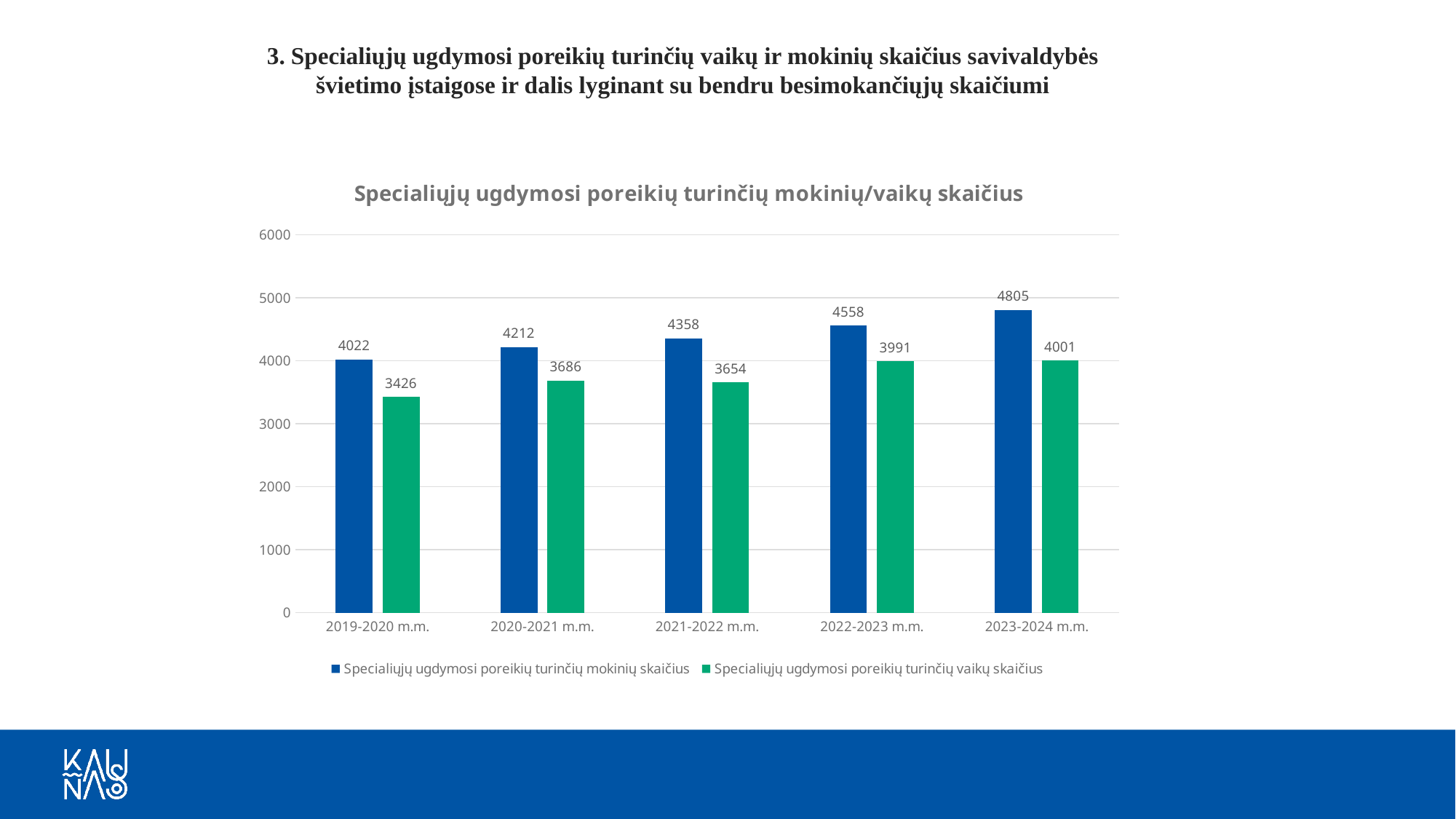
What is the value for 'Specialiųjų ugdymosi poreikių turinčių vaikų skaičius' in 2021-2022 m.m.? 3654 What is the value for 'Specialiųjų ugdymosi poreikių turinčių mokinių skaičius' in 2019-2020 m.m.? 4022 Does 'Specialiųjų ugdymosi poreikių turinčių mokinių skaičius' rise or fall across the school years from 2019-2020 to 2023-2024? Rises How many school years are shown on the x axis? 5 What is the value for 'Specialiųjų ugdymosi poreikių turinčių mokinių skaičius' in 2023-2024 m.m.? 4805 By how much did 'Specialiųjų ugdymosi poreikių turinčių mokinių skaičius' increase from 2019-2020 m.m. to 2023-2024 m.m.? 783 In which school year is 'Specialiųjų ugdymosi poreikių turinčių vaikų skaičius' the lowest? 2019-2020 m.m. Which is larger in 2020-2021 m.m.: the mokinių skaičius or the vaikų skaičius? Specialiųjų ugdymosi poreikių turinčių mokinių skaičius What kind of chart is shown on the slide? Bar chart What is the difference between the mokinių skaičius and the vaikų skaičius in 2022-2023 m.m.? 567 In which school year is 'Specialiųjų ugdymosi poreikių turinčių mokinių skaičius' the highest? 2023-2024 m.m. How many series does the legend list? 2